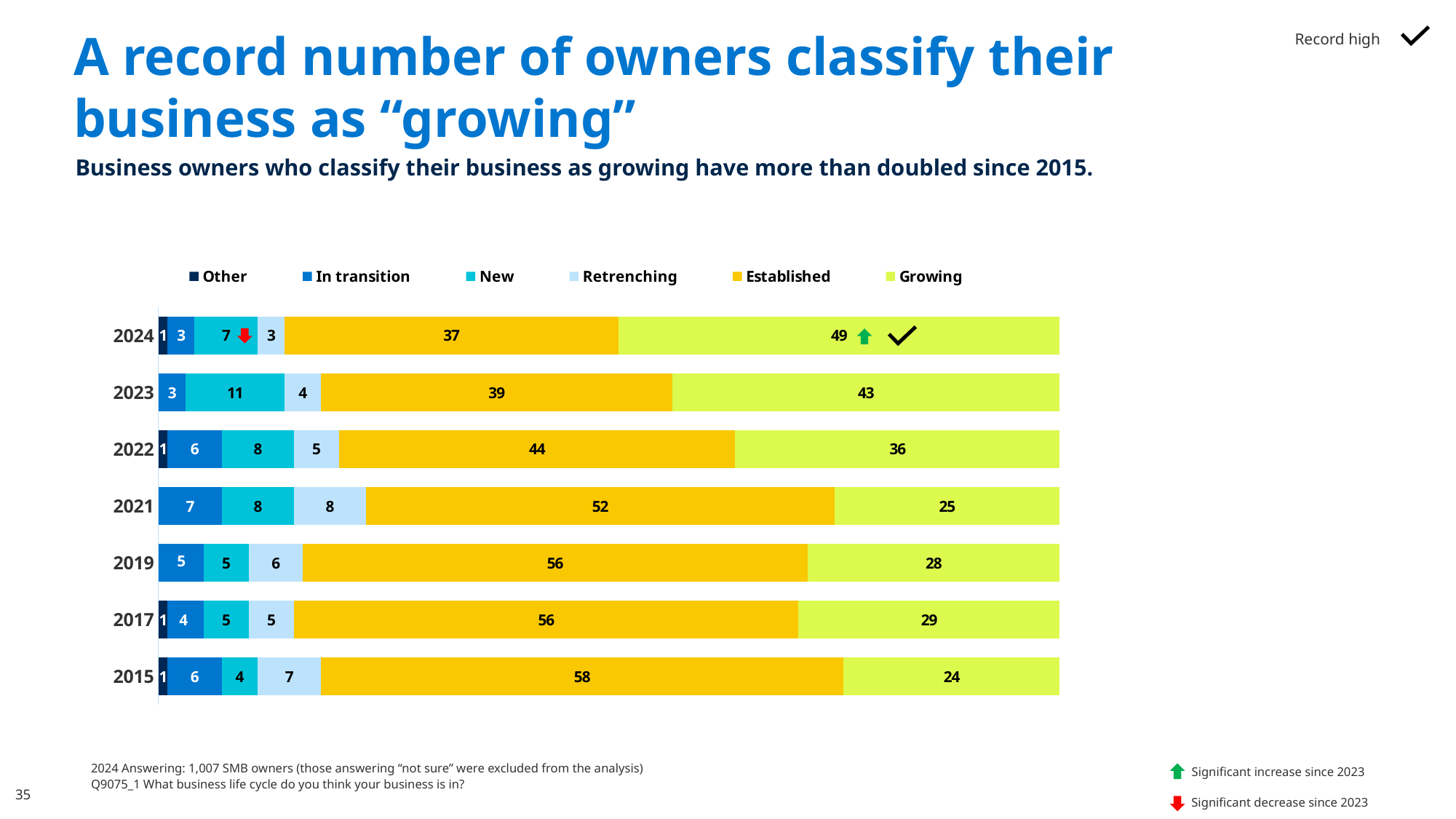
In which year is the Growing value highest? 2024 How many years are shown on the chart? 7 What is the total of the stacked bar for 2024? 100 In which year is the Growing value lowest? 2015 What is the value for Established in 2015? 58 What is the value for New in 2023? 11 Which is larger, the Established value in 2022 or the Established value in 2021? 2021 What kind of chart is shown on the slide? Stacked bar chart What is the value for Growing in 2024? 49 What is the value for Retrenching in 2021? 8 How many series does the legend list? 6 What is the difference between the Growing value in 2024 and in 2023? 6